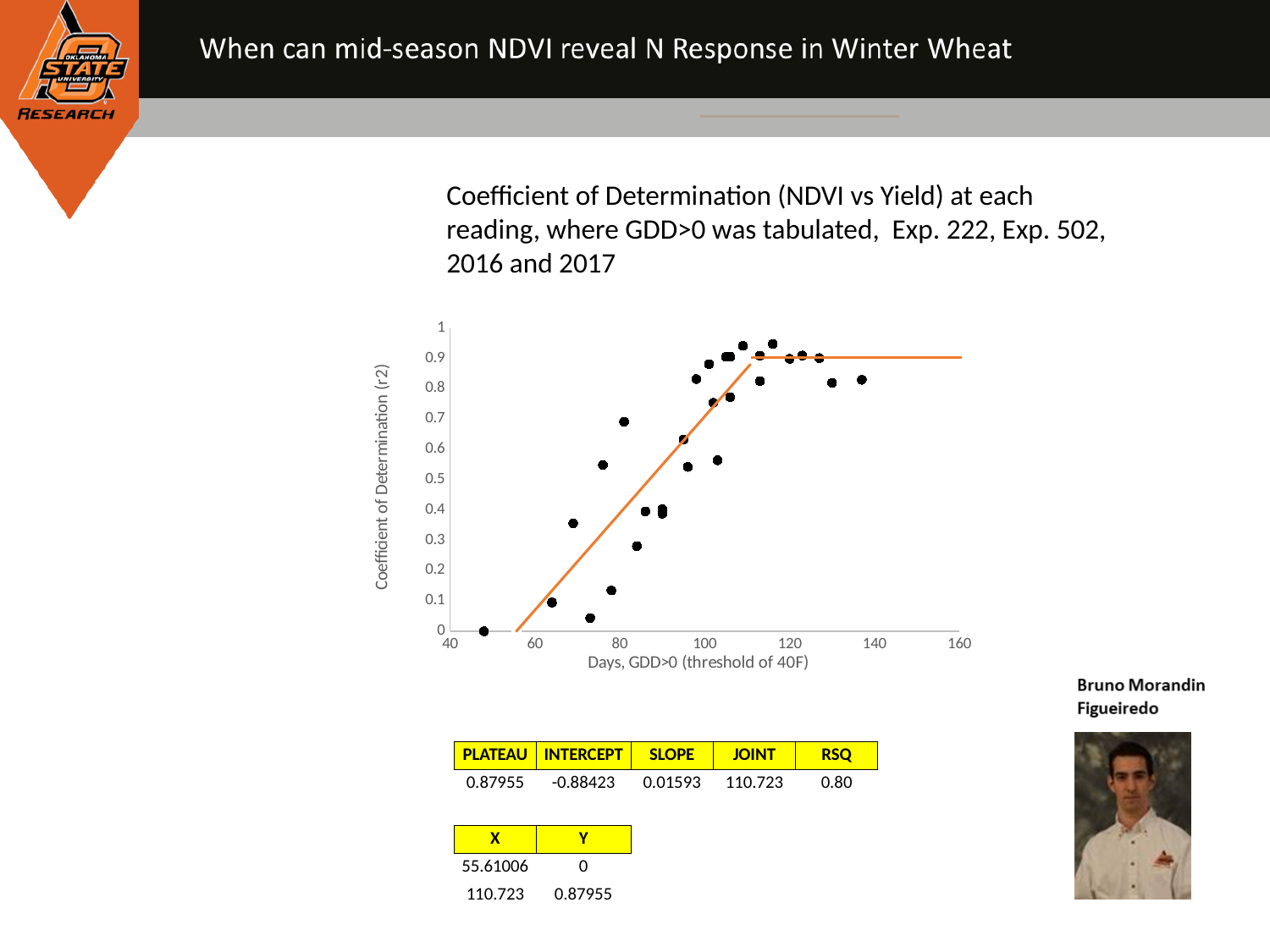
What kind of chart is shown on the slide? scatter chart Is the highest plotted point greater or less than 0.9? greater What is the label of the x axis? Days, GDD>0 (threshold of 40F) Is the leftmost plotted point (near 48 days) greater or less than 0.1? less Is the rightmost plotted point (near 137 days) greater or less than 0.9? less What is the label of the y axis? Coefficient of Determination (r2) Do the plotted coefficient of determination values generally rise or fall as days (GDD>0) increase from 40 to about 110? rise Which is larger, the leftmost plotted point or the rightmost plotted point? the rightmost plotted point